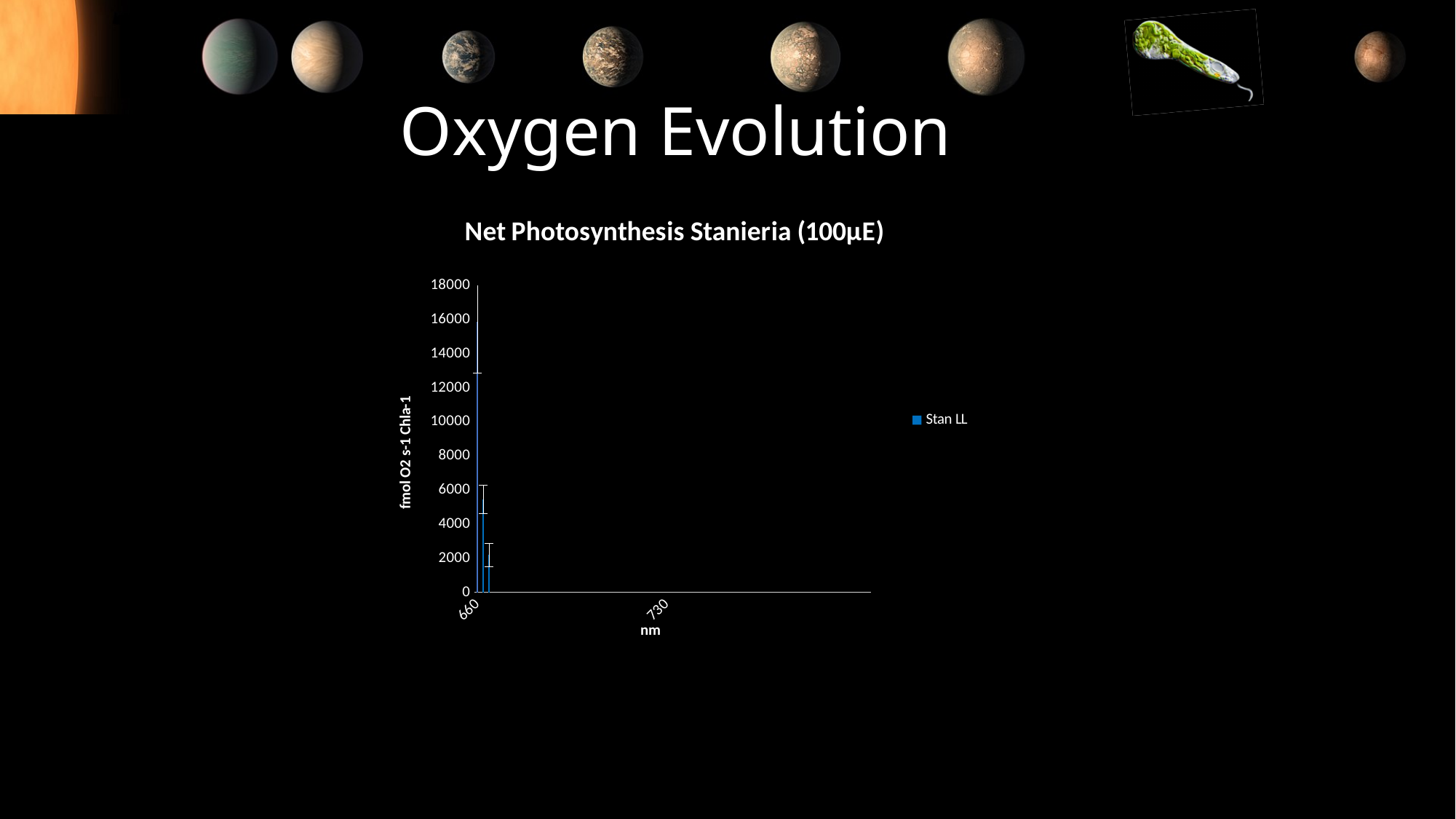
What is the title of the chart? Net Photosynthesis Stanieria (100μE) What is the label on the y axis of the chart? fmol O2 s-1 Chla-1 Which two wavelength labels appear on the x axis of the chart? 660 and 730 Is the tallest bar in the chart greater or less than 10000? greater What kind of chart is shown on the slide? bar chart How many series does the chart legend list? 1 Is the shortest bar in the chart greater or less than 4000? less